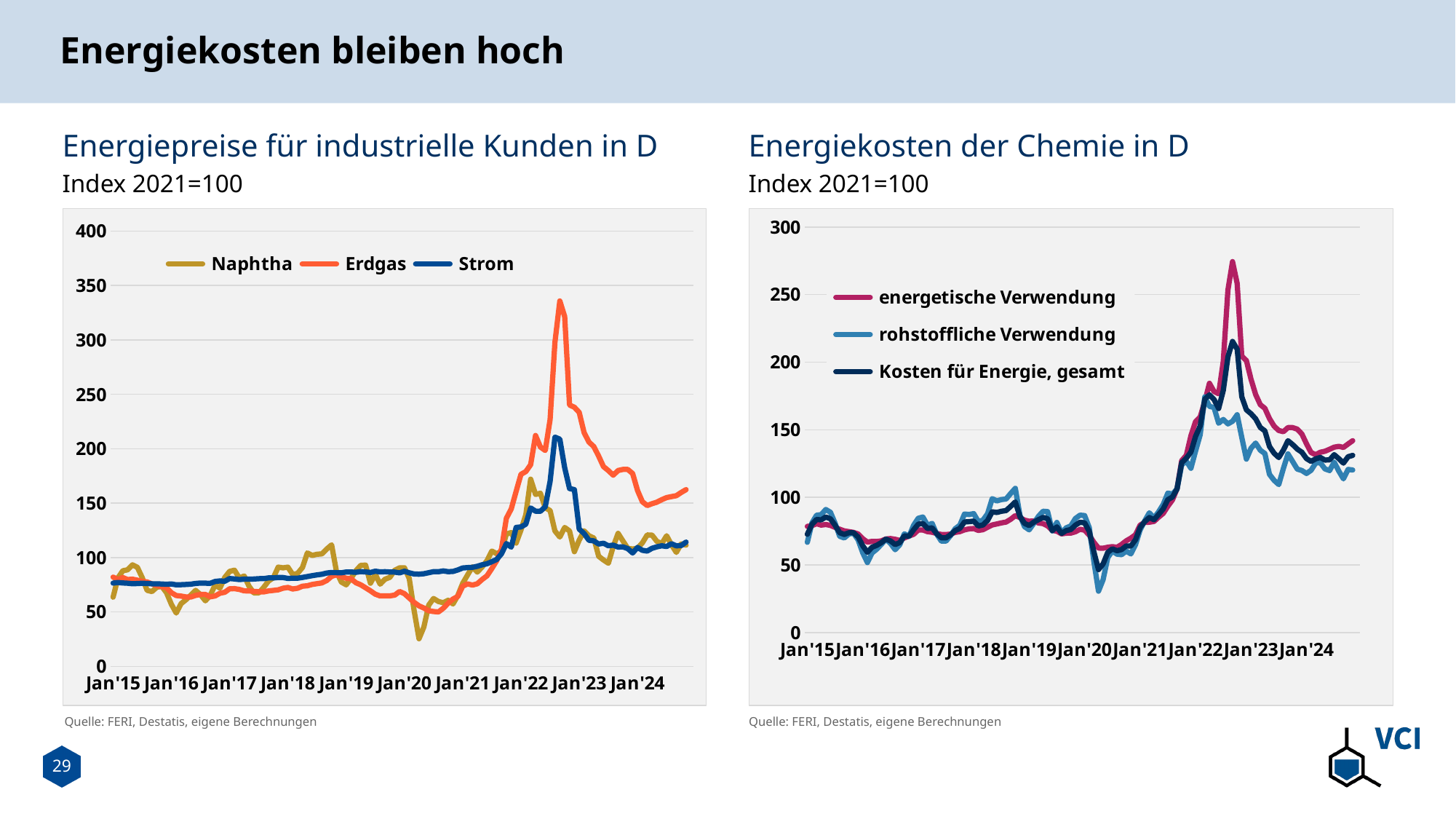
In the right chart 'Energiekosten der Chemie in D', does the energetische Verwendung series rise or fall from its 2022 peak to Jan'24? fall How many series does the legend of the right chart 'Energiekosten der Chemie in D' list? 3 In the right chart 'Energiekosten der Chemie in D', which series reaches the highest peak? energetische Verwendung In the left chart 'Energiepreise für industrielle Kunden in D', is the peak value of Strom greater or less than 250? less How many series does the legend of the left chart 'Energiepreise für industrielle Kunden in D' list? 3 In the left chart 'Energiepreise für industrielle Kunden in D', is the lowest value of Naphtha around 2020 greater or less than 50? less In the left chart 'Energiepreise für industrielle Kunden in D', which series reaches the highest peak? Erdgas In the left chart 'Energiepreise für industrielle Kunden in D', which peaks higher, Erdgas or Strom? Erdgas What kind of chart is the left chart, 'Energiepreise für industrielle Kunden in D'? line chart What index base is stated under both chart titles? Index 2021=100 In the right chart 'Energiekosten der Chemie in D', is the peak value of energetische Verwendung greater or less than 250? greater